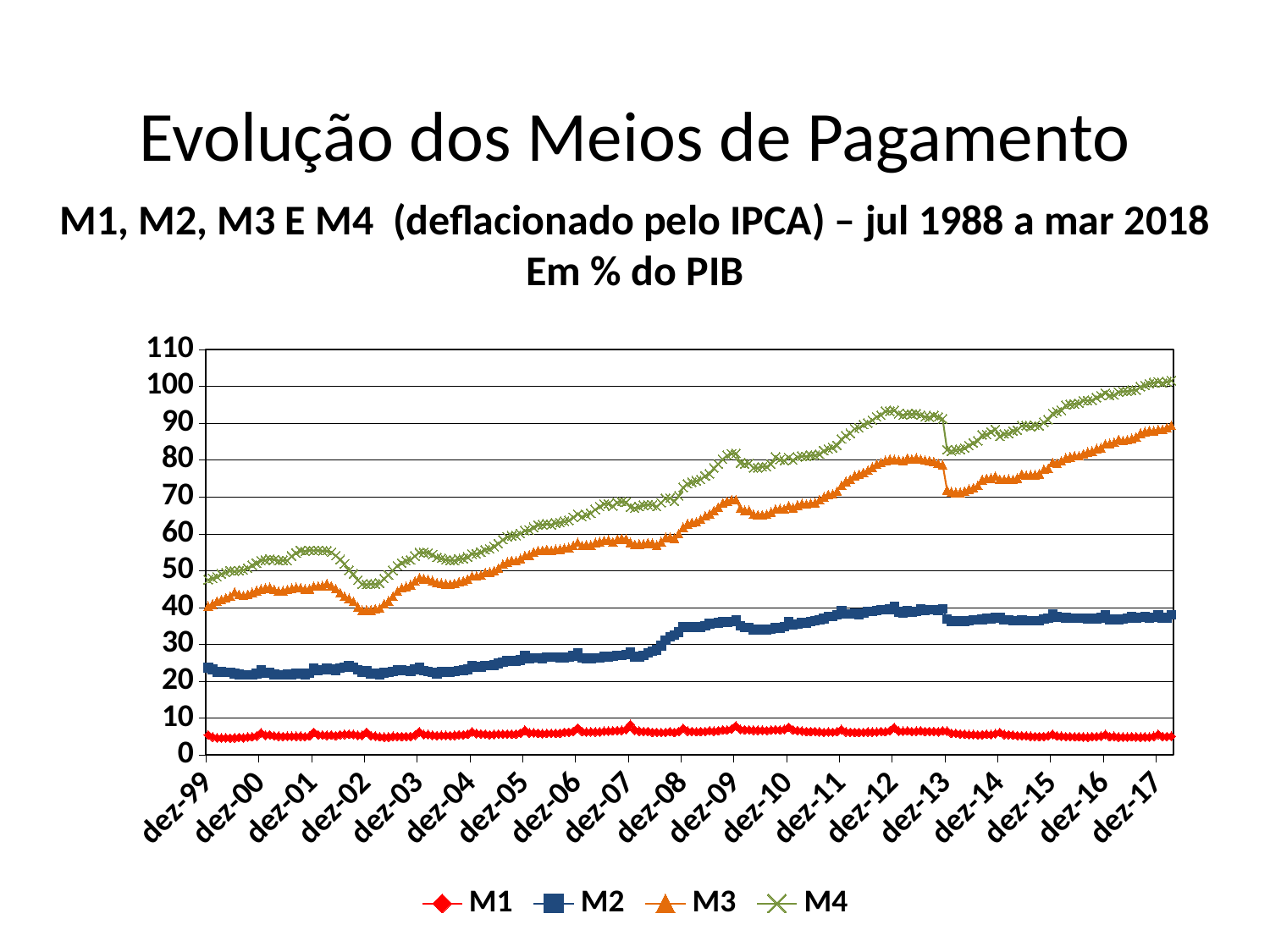
Is the value for M2 at dez-17 greater or less than 50? less Is the value for M3 at dez-17 greater or less than 80? greater At dez-17, which is larger, M4 or M3? M4 Does the M4 series generally rise or fall from dez-99 to dez-17? rise Is the value for M4 at dez-17 greater or less than 90? greater Which series has the highest values across the whole period? M4 What kind of chart is shown on the slide? line chart Which series are listed in the legend? M1, M2, M3, M4 What is the title of the slide? Evolução dos Meios de Pagamento Which series has the lowest values across the whole period? M1 How many series does the legend list? 4